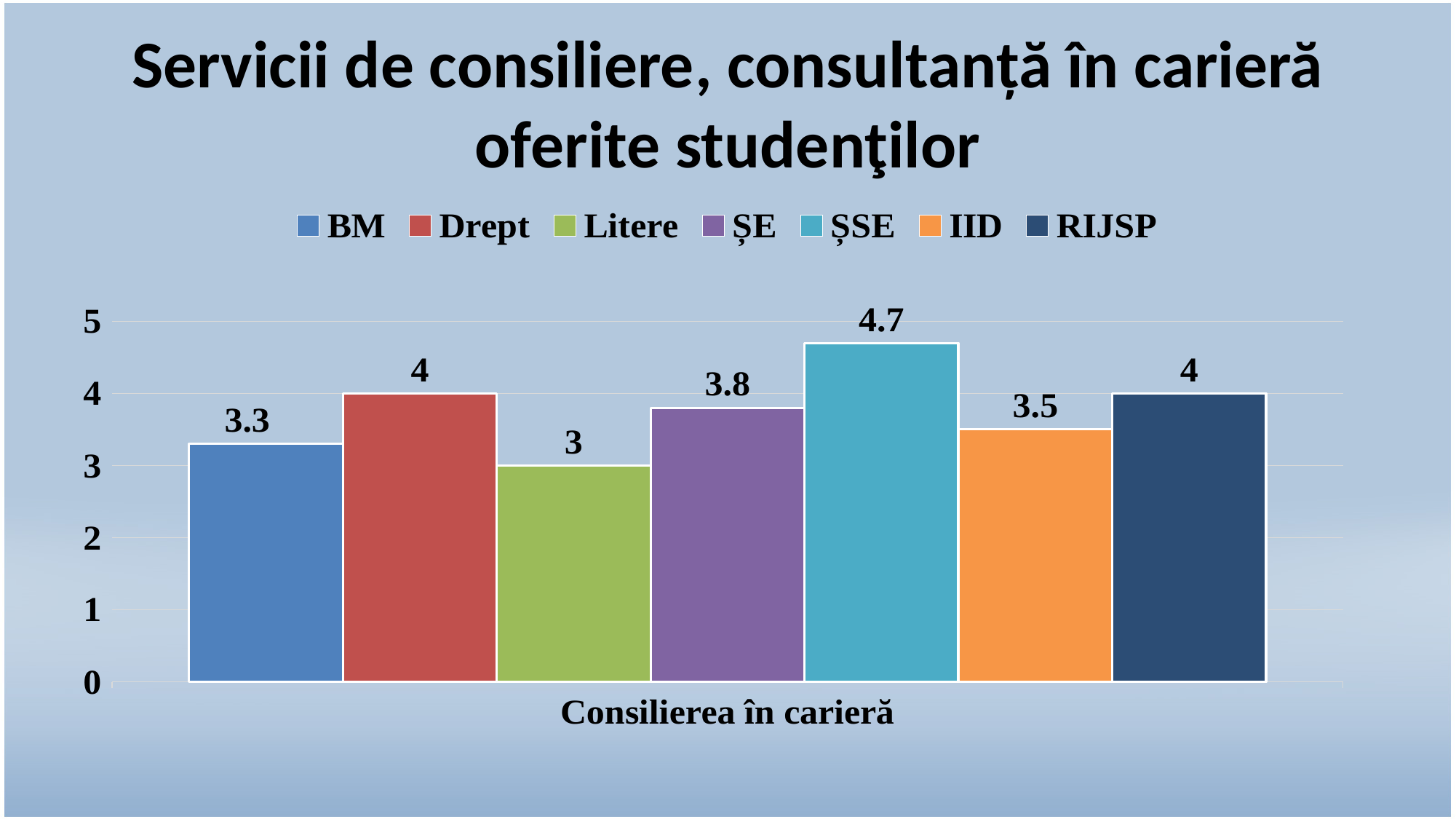
What is the label on the x axis of the chart? Consilierea în carieră How many series does the legend list? 7 What kind of chart is shown on the slide? bar chart What is the difference between the values for ȘSE and Litere? 1.7 Is the value for ȘE greater or less than 4? less Which series has the highest value? ȘSE Which series has the lowest value? Litere What is the value for BM? 3.3 What is the value for IID? 3.5 What is the difference between the values for ȘE and BM? 0.5 Which is larger, the value for Drept or the value for IID? Drept What is the value for ȘSE? 4.7